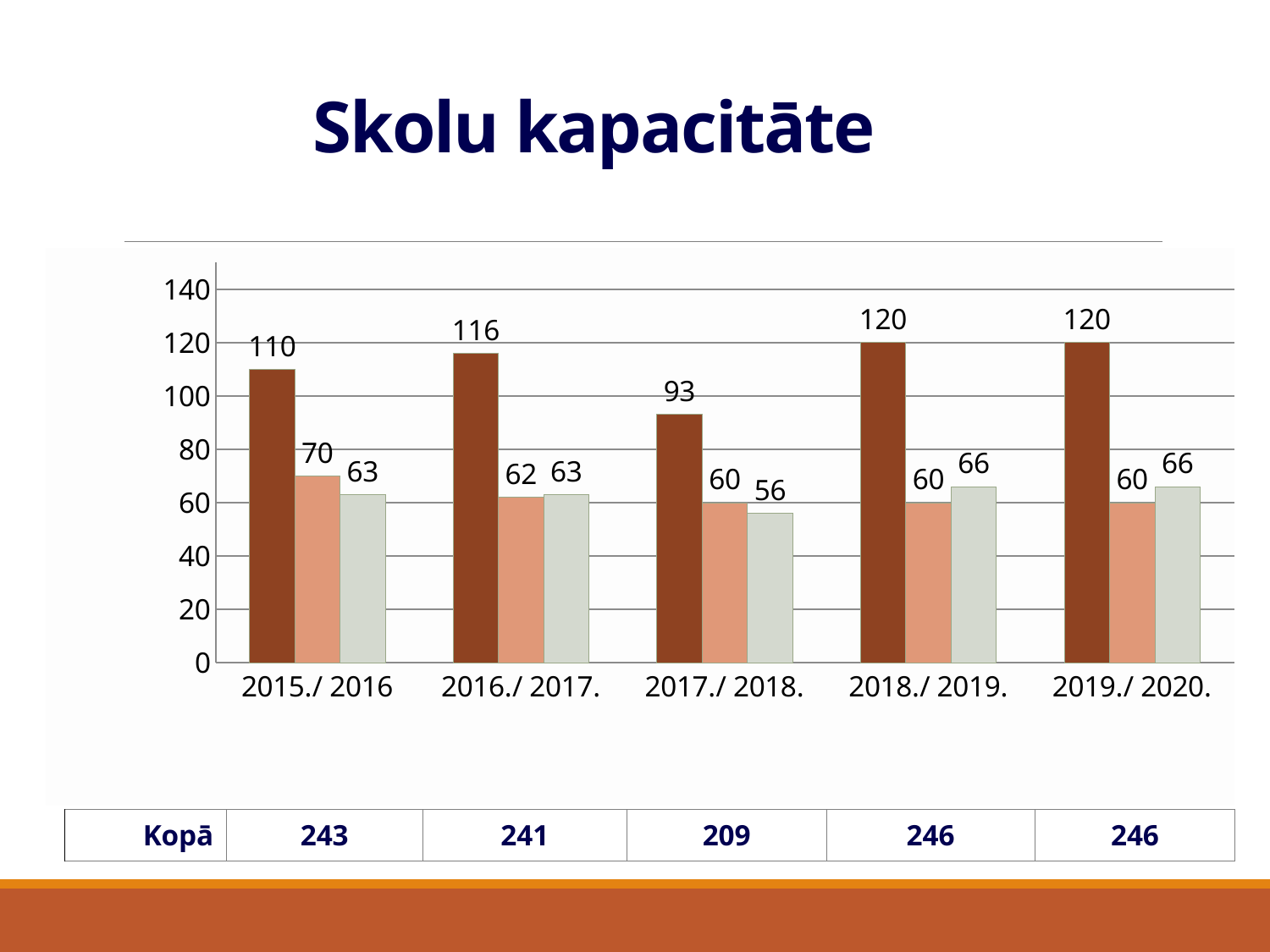
What is the difference between the dark brown bar values for 2016./ 2017. and 2017./ 2018.? 23 What is the value of the light grey bar for 2017./ 2018.? 56 In which school year is the light grey bar lowest? 2017./ 2018. Which is larger, the dark brown bar for 2015./ 2016 or for 2016./ 2017.? 2016./ 2017. What is the value of the orange (middle) bar for 2016./ 2017.? 62 What kind of chart is shown on the slide? bar chart How many school years are shown on the x axis? 5 What is the value of the dark brown bar for 2015./ 2016? 110 In which school year is the dark brown bar lowest? 2017./ 2018. What is the title of the slide? Skolu kapacitāte What is the sum of the three bar values for 2017./ 2018.? 209 In which school year is the orange (middle) bar highest? 2015./ 2016